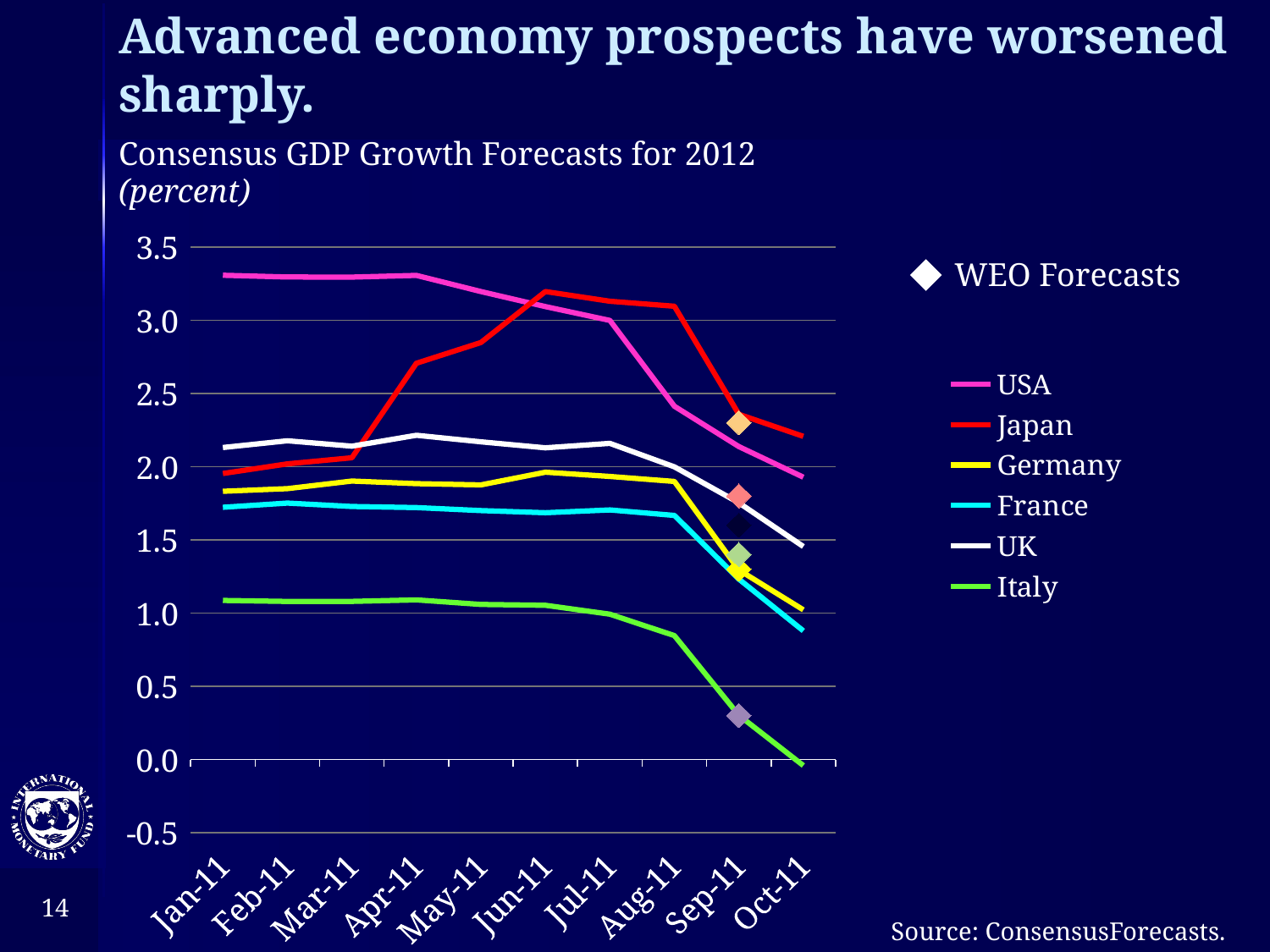
What kind of chart is shown on the slide? line chart How many months are shown along the x axis of the chart? 10 Is the USA forecast in Jan-11 greater or less than 3.0? greater Which country has the lowest forecast in Jan-11? Italy Is the Japan forecast in Jun-11 greater or less than 3.0? greater Is the Italy forecast in Oct-11 greater or less than 0.5? less Which country has the highest forecast in Jan-11? USA Does the Italy forecast rise or fall between Aug-11 and Oct-11? fall What is the title of the chart? Consensus GDP Growth Forecasts for 2012 In Oct-11, which is higher: the forecast for Japan or for the USA? Japan In Apr-11, which is higher: the forecast for the UK or for Germany? UK How many countries are listed in the chart's legend? 6